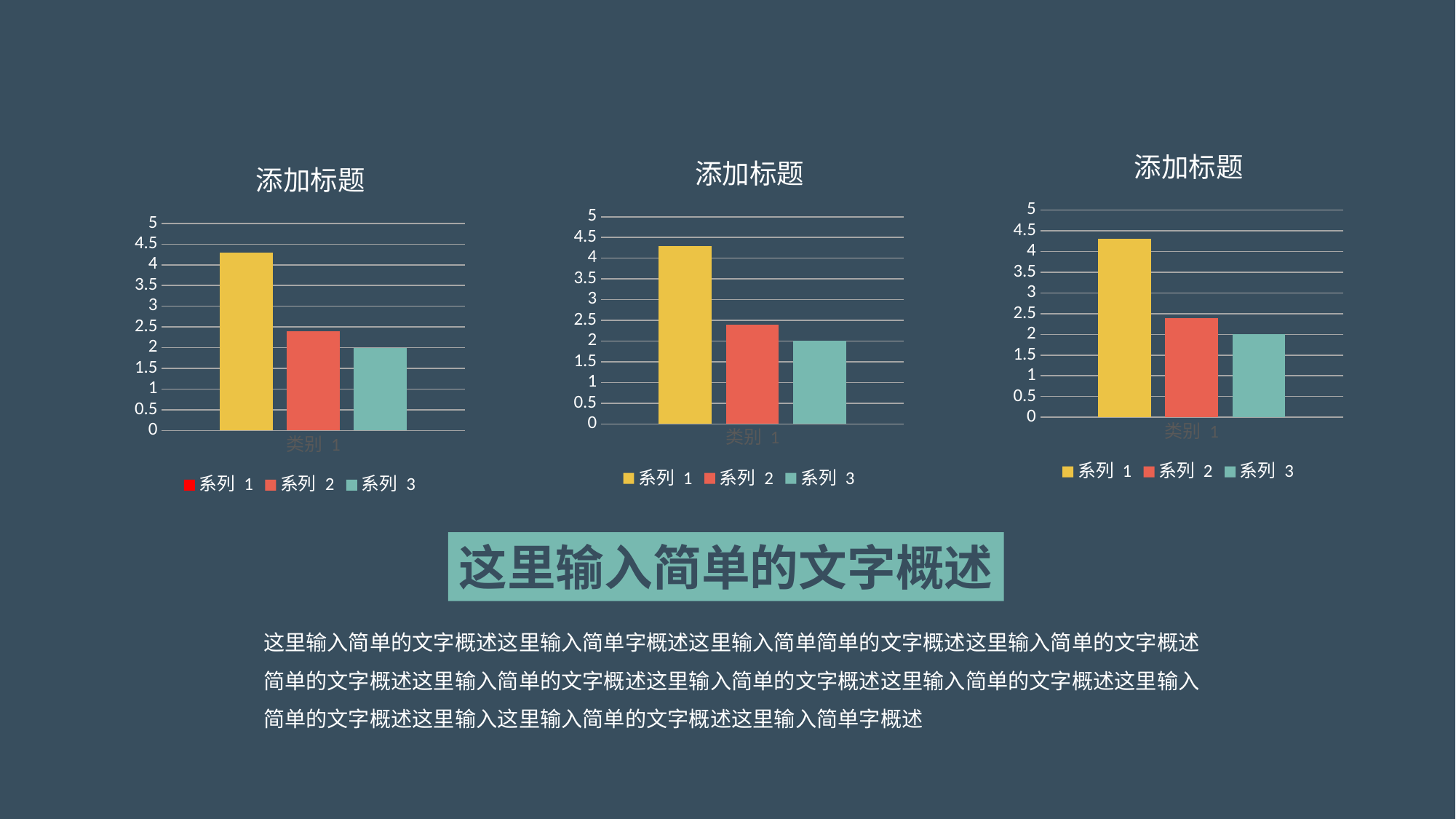
What is the title of the middle chart? 添加标题 What type of chart is the left chart on the slide? bar chart In the right chart, what is the value of 系列 3 for 类别 1? 2 In the right chart, is the value for 系列 1 greater or less than 3.5? greater What is the name of the single category on the x axis of the left chart? 类别 1 How many categories are shown on the x axis of the right chart? 1 In the left chart, which series has the highest bar? 系列 1 In the middle chart, which series has the lowest bar? 系列 3 In the left chart, is the value for 系列 1 greater or less than 4? greater In the left chart, which is larger, the bar for 系列 1 or the bar for 系列 2? 系列 1 In the middle chart, is the value for 系列 2 greater or less than 3? less How many series does the legend of the middle chart list? 3